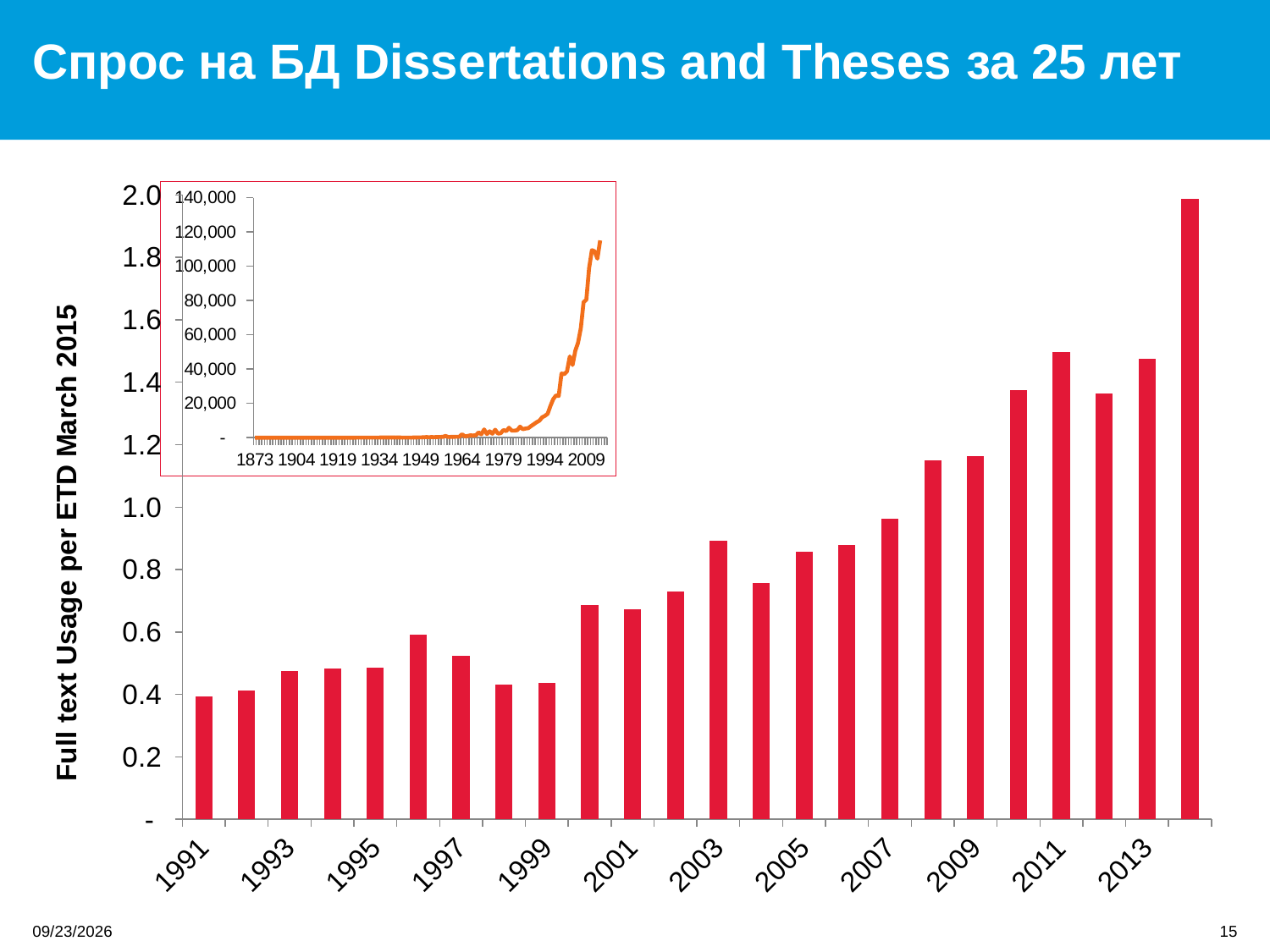
In the large bar chart, which year has the larger value, 2001 or 2003? 2003 In the large bar chart, is the value for 2011 greater or less than 1.4? greater What is the title of the vertical axis of the large bar chart? Full text Usage per ETD March 2015 In the large bar chart, which year has the larger value, 1997 or 1999? 1997 In the large bar chart, is the value for 1991 greater or less than 0.6? less In the large bar chart, do the values generally rise or fall from 1991 to the last year shown? Rise In the large bar chart, is the value for 2007 greater or less than 1.0? less What kind of chart is the small inset chart in the upper left? Line chart In the large bar chart, how many bars are plotted? 24 What kind of chart is the large chart with red bars? Bar chart